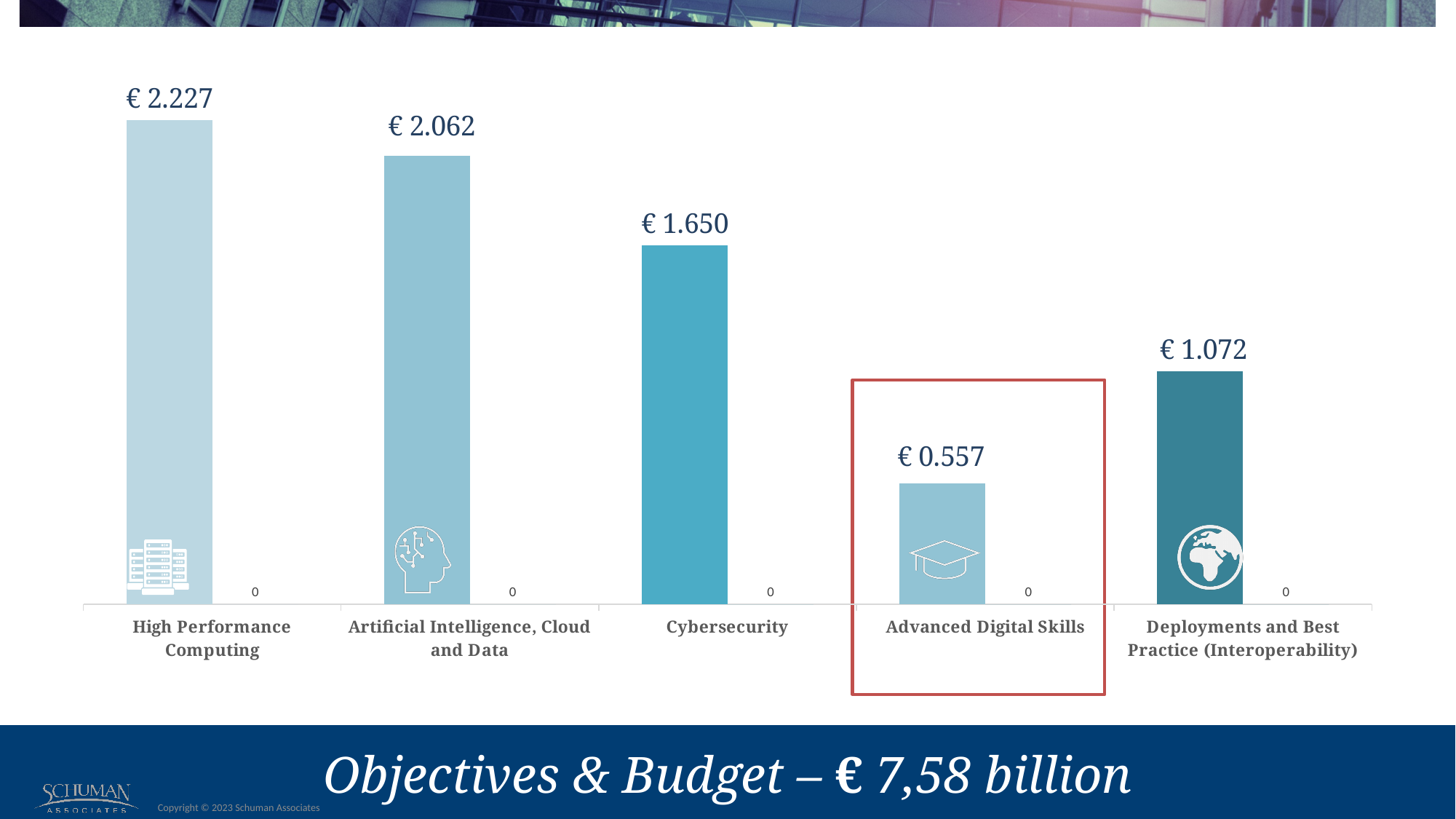
How many categories are shown in the chart? 5 Which is larger, Cybersecurity or Deployments and Best Practice (Interoperability)? Cybersecurity What is the difference between Cybersecurity and Deployments and Best Practice (Interoperability)? € 0.578 Which category has the highest value? High Performance Computing What is the value for Deployments and Best Practice (Interoperability)? € 1.072 What is the value for High Performance Computing? € 2.227 Which category has the lowest value? Advanced Digital Skills Which category is highlighted with a red box? Advanced Digital Skills What kind of chart is shown on the slide? Bar chart What is the value for Advanced Digital Skills? € 0.557 What is the value for Cybersecurity? € 1.650 What is the difference between High Performance Computing and Artificial Intelligence, Cloud and Data? € 0.165